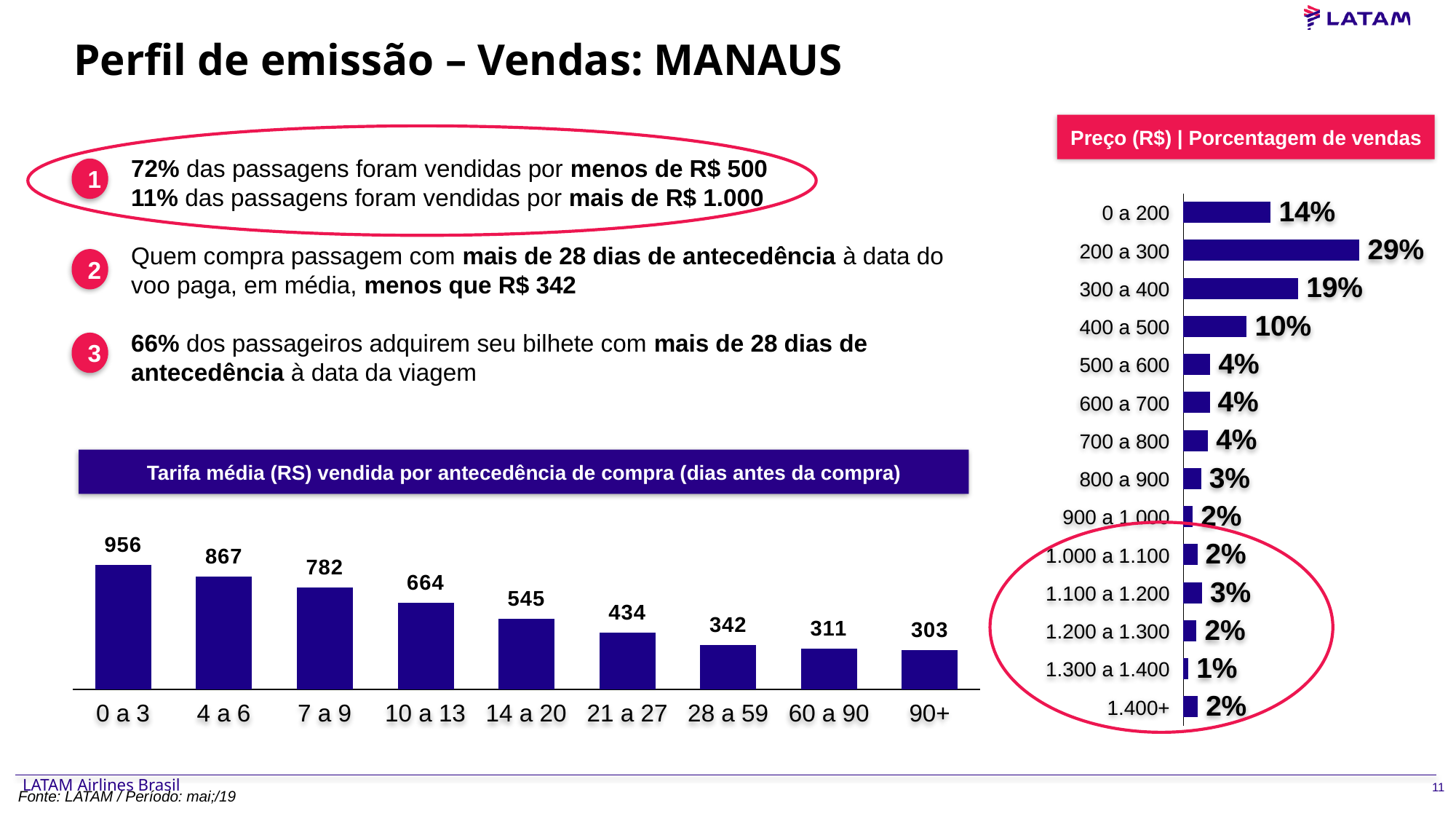
In the chart 'Preço (R$) | Porcentagem de vendas', what is the value for '200 a 300'? 29% In the chart 'Tarifa média (RS) vendida por antecedência de compra', what is the value for '28 a 59'? 342 In the chart 'Preço (R$) | Porcentagem de vendas', which price range has the highest percentage of sales? 200 a 300 How many categories are shown in the chart 'Tarifa média (RS) vendida por antecedência de compra'? 9 In the chart 'Tarifa média (RS) vendida por antecedência de compra', do the values rise or fall from left to right along the x axis? fall In the chart 'Preço (R$) | Porcentagem de vendas', which is larger, the value for '300 a 400' or the value for '400 a 500'? 300 a 400 In the chart 'Tarifa média (RS) vendida por antecedência de compra', what is the value for '0 a 3'? 956 In the chart 'Tarifa média (RS) vendida por antecedência de compra', what is the difference between the values for '0 a 3' and '4 a 6'? 89 How many price ranges are shown in the chart 'Preço (R$) | Porcentagem de vendas'? 14 In the chart 'Tarifa média (RS) vendida por antecedência de compra', which category has the lowest value? 90+ What kind of chart is 'Preço (R$) | Porcentagem de vendas'? bar chart In the chart 'Preço (R$) | Porcentagem de vendas', which price range has the lowest percentage of sales? 1.300 a 1.400